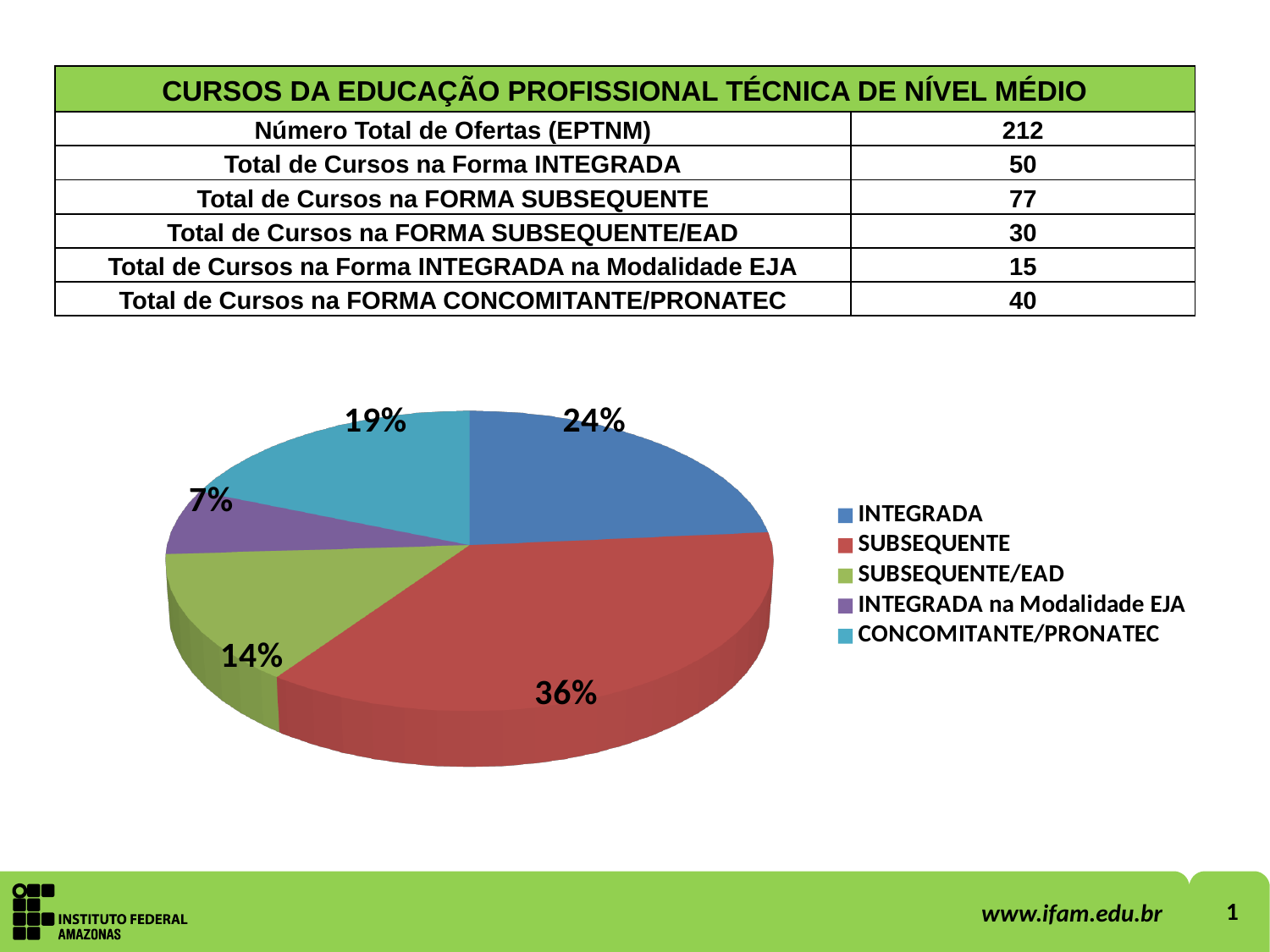
What share of the pie does the CONCOMITANTE/PRONATEC slice represent? 19% What kind of chart is shown on the slide? pie chart What colour is the SUBSEQUENTE slice in the pie chart? red Which slice is larger, CONCOMITANTE/PRONATEC or SUBSEQUENTE/EAD? CONCOMITANTE/PRONATEC How many slices does the pie chart have? 5 What share of the pie does the SUBSEQUENTE/EAD slice represent? 14% What share of the pie does the SUBSEQUENTE slice represent? 36% Which category has the smallest slice of the pie? INTEGRADA na Modalidade EJA Which category has the largest slice of the pie? SUBSEQUENTE What is the difference in percentage points between the SUBSEQUENTE and INTEGRADA slices? 12